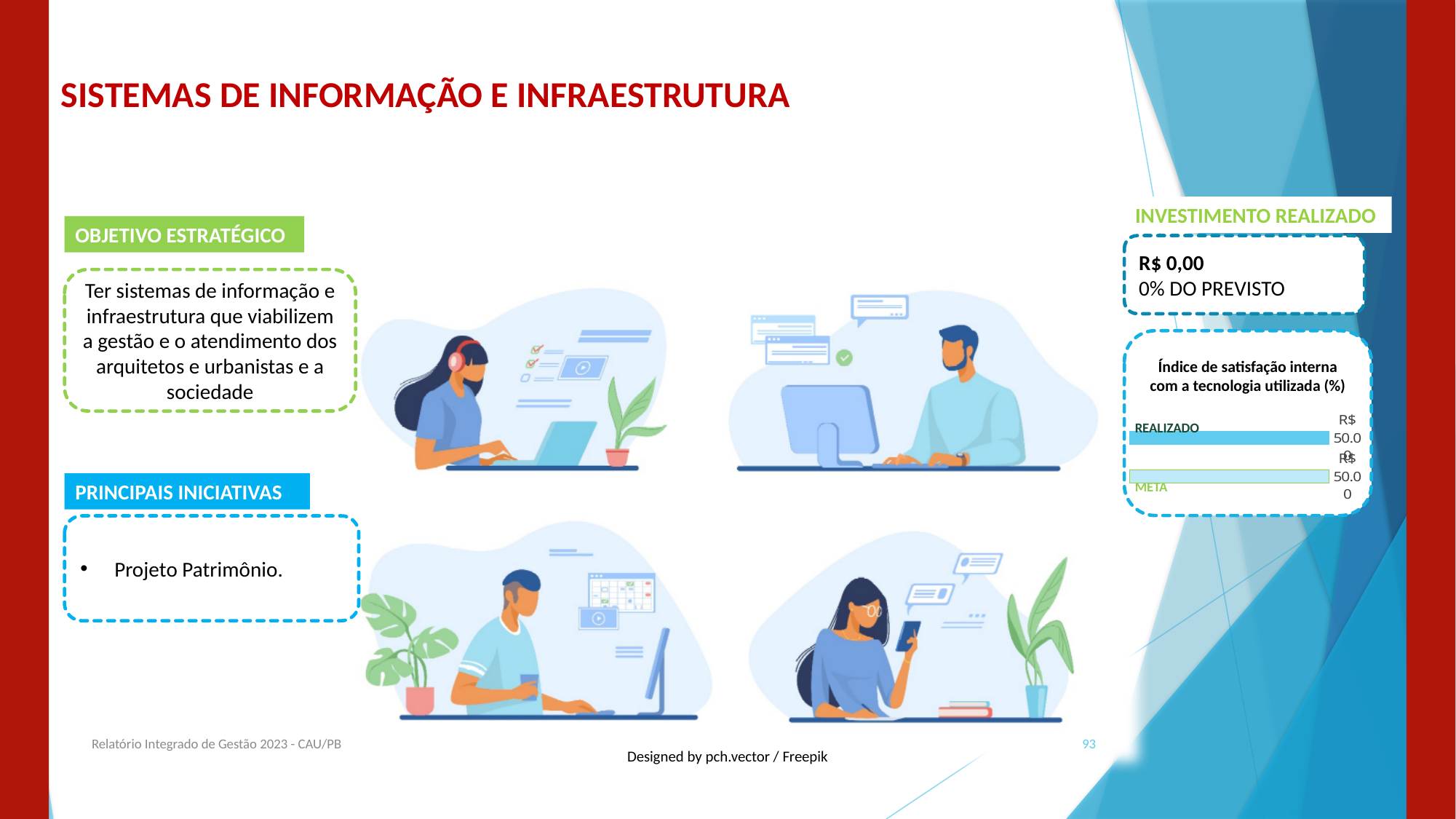
What are the two categories labelled on the 'Índice de satisfação interna com a tecnologia utilizada (%)' chart? REALIZADO and META What is the title of the bar chart on the right side of the slide? Índice de satisfação interna com a tecnologia utilizada (%) What kind of chart is shown under the heading 'Índice de satisfação interna com a tecnologia utilizada (%)'? bar chart How many bars does the 'Índice de satisfação interna com a tecnologia utilizada (%)' chart show? 2 In the 'Índice de satisfação interna com a tecnologia utilizada (%)' chart, what value is labelled on the META bar? R$ 50.00 In the 'Índice de satisfação interna com a tecnologia utilizada (%)' chart, what value is labelled on the REALIZADO bar? R$ 50.00